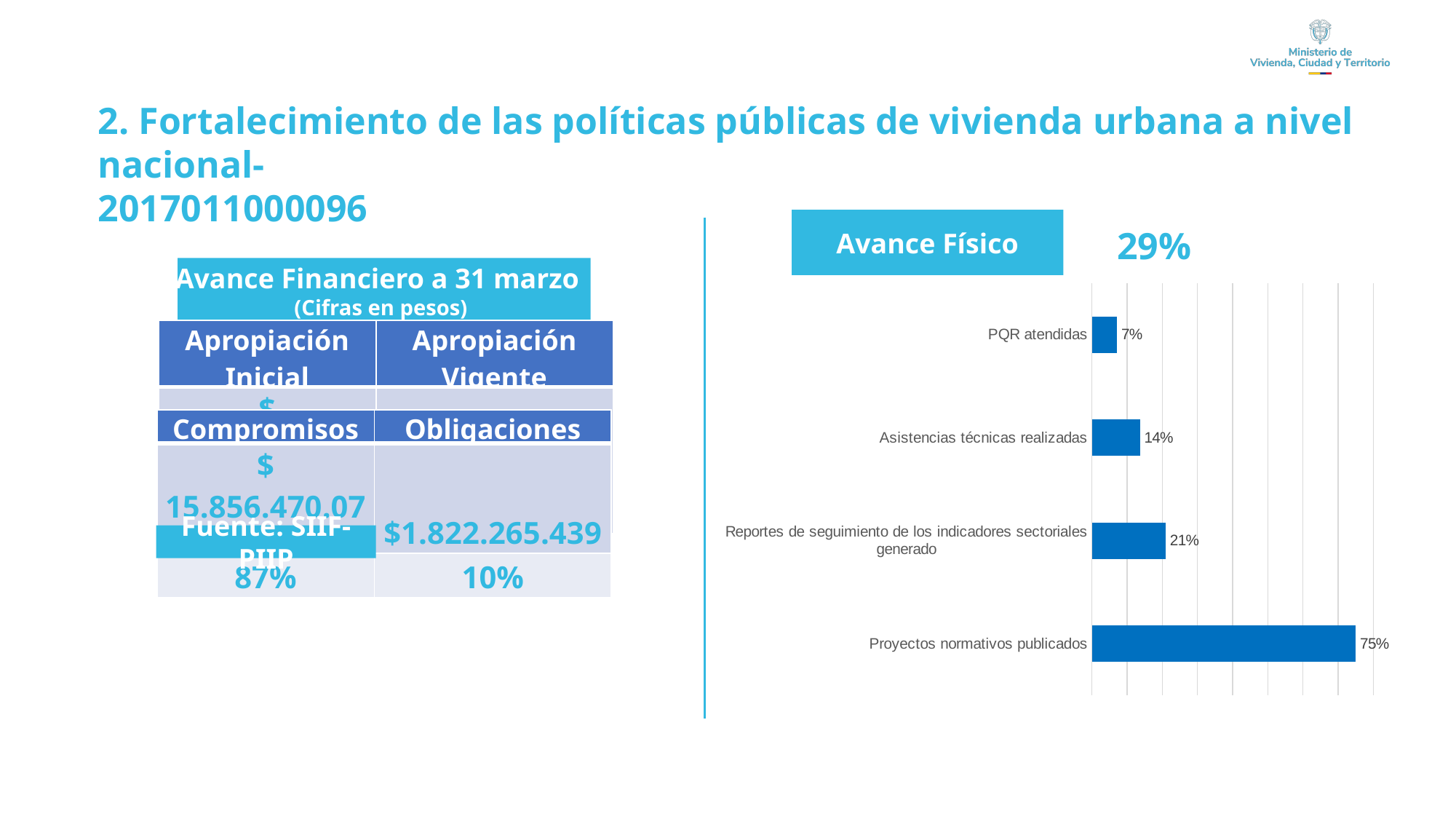
What is the value for PQR atendidas? 7% What is the title shown above the bar chart? Avance Físico Which category has the highest value in the bar chart? Proyectos normativos publicados What is the value for Asistencias técnicas realizadas? 14% What is the difference between the values for Asistencias técnicas realizadas and PQR atendidas? 7% Which is larger, the value for Asistencias técnicas realizadas or the value for Reportes de seguimiento de los indicadores sectoriales generado? Reportes de seguimiento de los indicadores sectoriales generado What type of chart is shown on the slide? bar chart How many categories does the bar chart show? 4 What is the difference between the values for Proyectos normativos publicados and Reportes de seguimiento de los indicadores sectoriales generado? 54% What is the value for Reportes de seguimiento de los indicadores sectoriales generado? 21% Which category has the lowest value in the bar chart? PQR atendidas What is the value for Proyectos normativos publicados? 75%